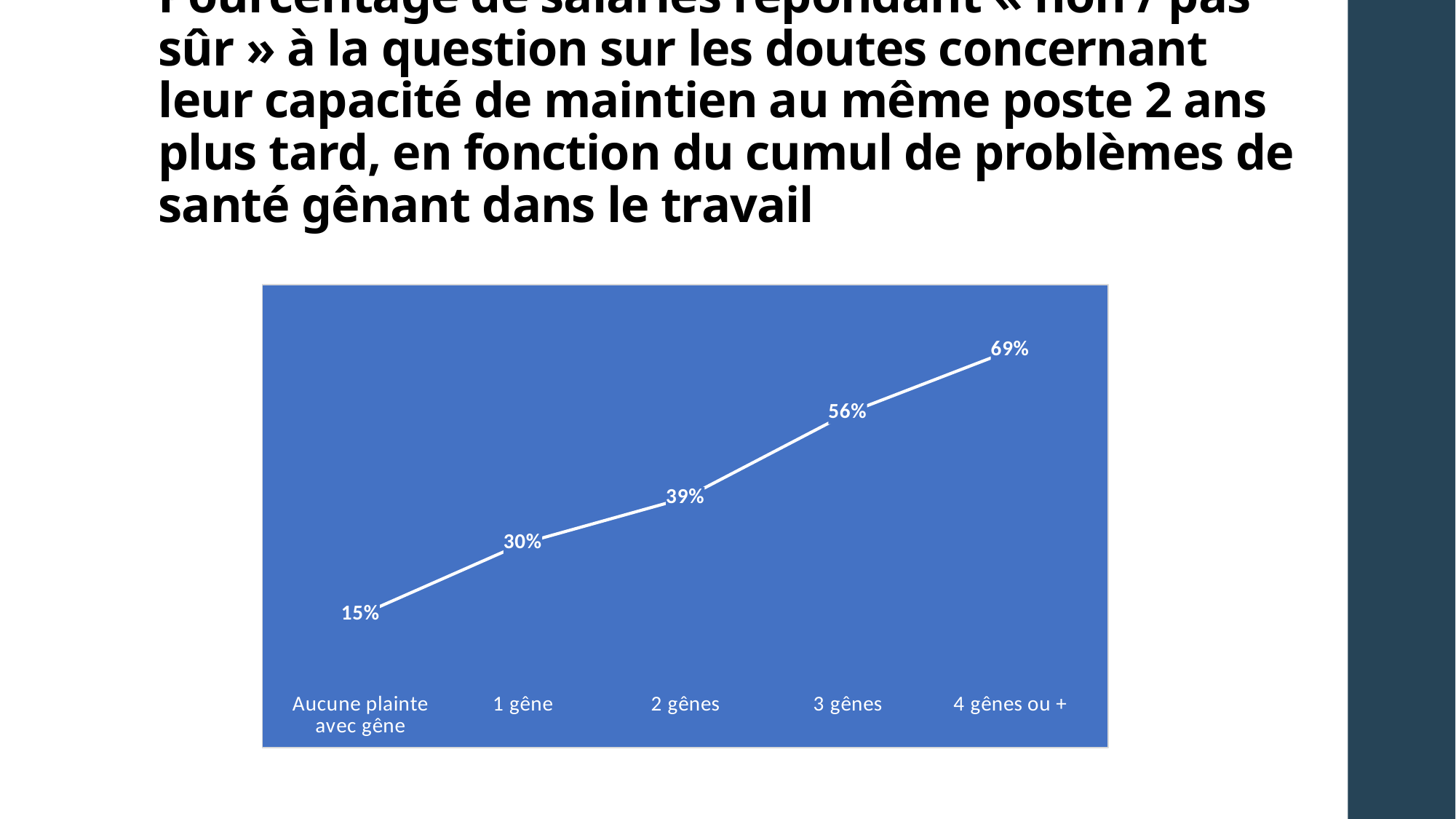
What is the value for "1 gêne"? 30% Which category has the highest value? 4 gênes ou + What is the value for "Aucune plainte avec gêne"? 15% How many categories are plotted on the x axis? 5 Which category has the lowest value? Aucune plainte avec gêne What is the value for "3 gênes"? 56% What is the difference between the values for "4 gênes ou +" and "Aucune plainte avec gêne"? 54% What kind of chart is shown on the slide? Line chart What is the value for "4 gênes ou +"? 69% What is the value for "2 gênes"? 39% Which is larger, the value for "1 gêne" or the value for "2 gênes"? 2 gênes What is the difference between the values for "3 gênes" and "2 gênes"? 17%